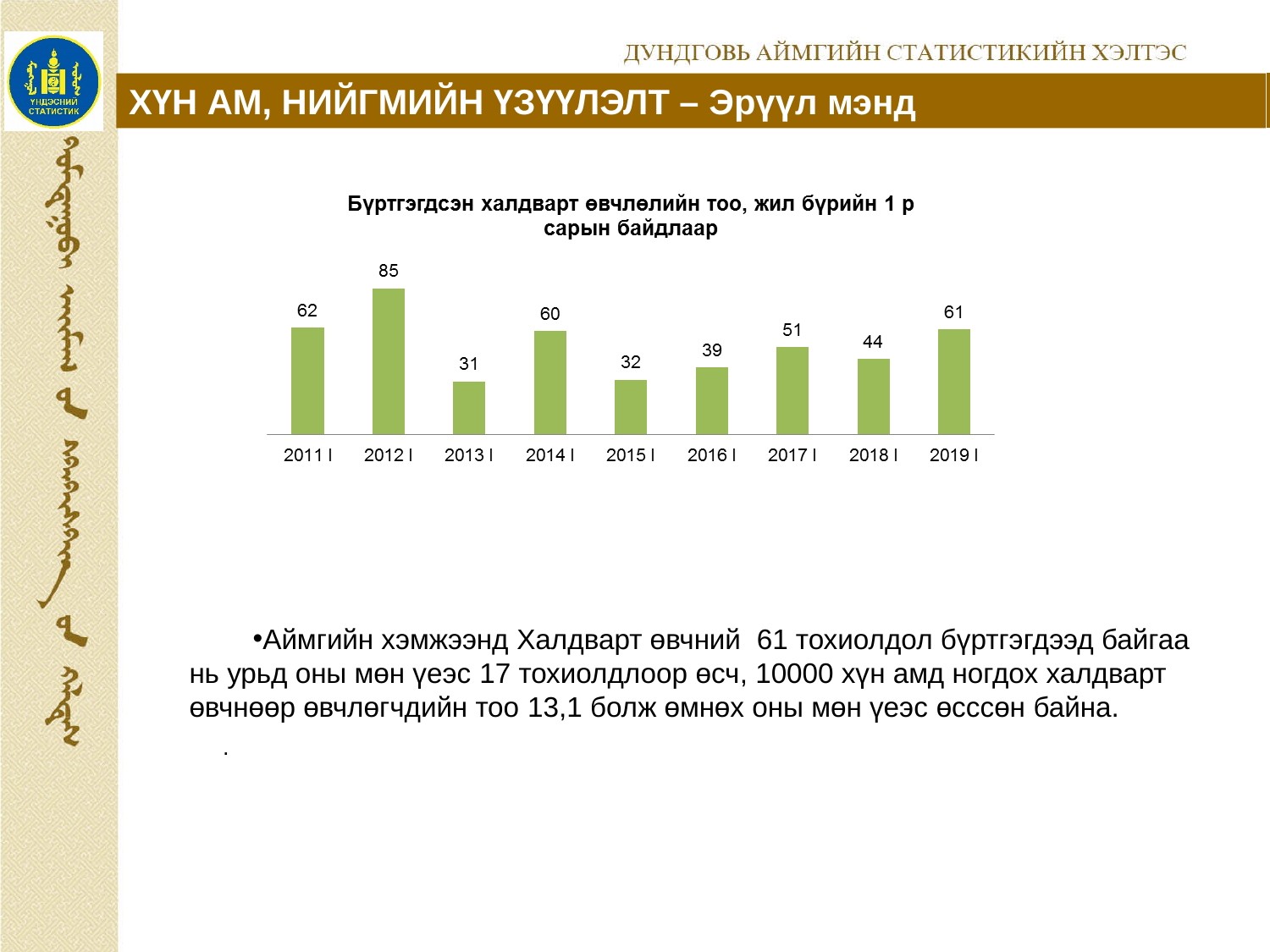
Which category has the lowest value? 2013 I Which is larger, the value for 2011 I or the value for 2014 I? 2011 I What is the value for 2015 I? 32 Do the values rise or fall from 2015 I to 2017 I? rise How many categories are shown on the x axis? 9 What is the difference between the values for 2012 I and 2013 I? 54 Which category has the highest value? 2012 I What is the value for 2019 I? 61 What is the title of the chart? Бүртгэгдсэн халдварт өвчлөлийн тоо, жил бүрийн 1 р сарын байдлаар What is the value for 2012 I? 85 What is the difference between the values for 2019 I and 2018 I? 17 What kind of chart is shown on the slide? bar chart